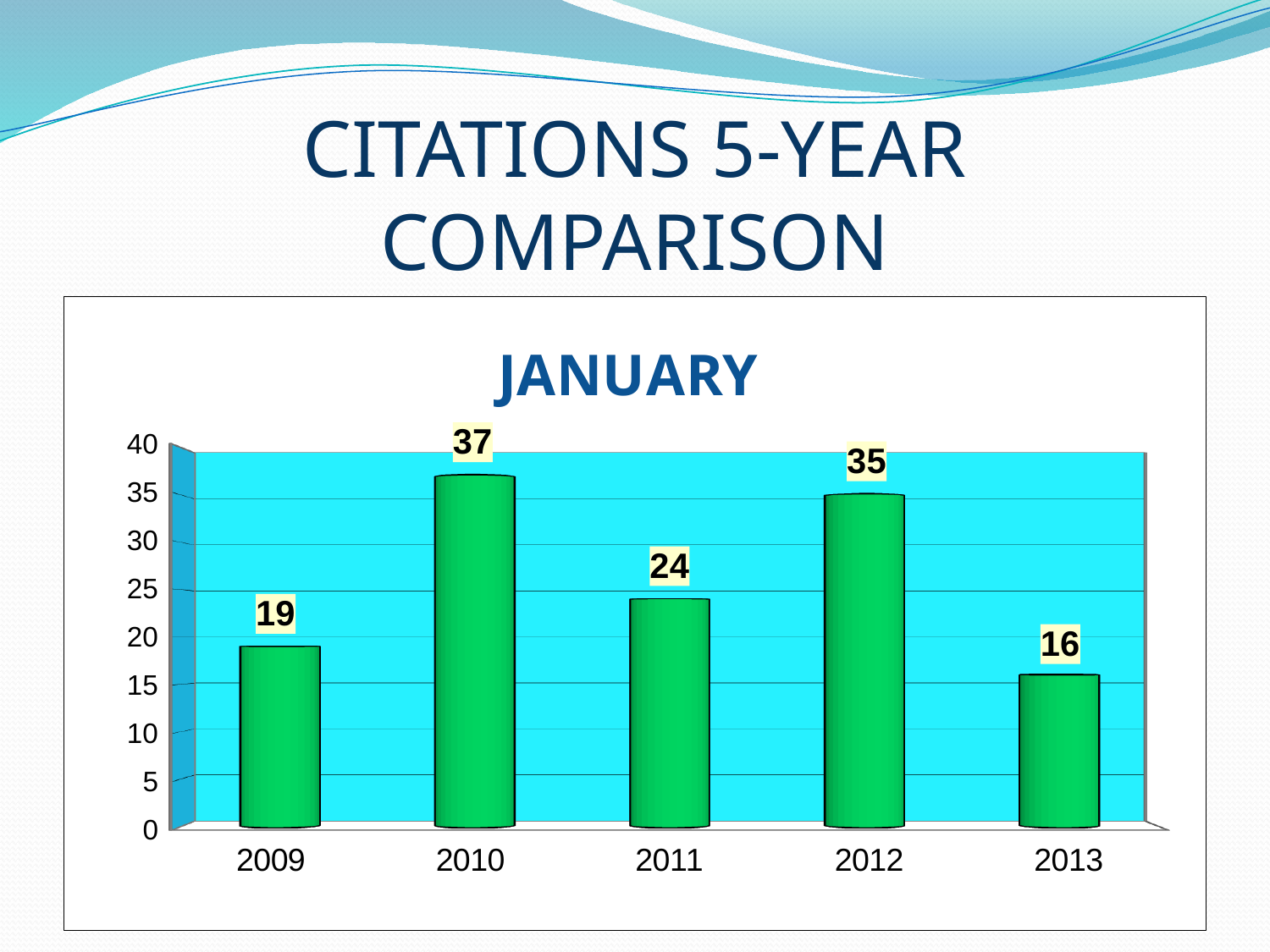
What is the value for 2011? 24 What is the value for 2013? 16 What kind of chart is shown? bar chart What is the difference between the values for 2010 and 2012? 2 Which is larger, the value for 2011 or the value for 2012? 2012 What is the difference between the values for 2009 and 2013? 3 What is the title of the chart? JANUARY How many years are shown on the x axis? 5 Is the value for 2009 greater or less than 20? less Which year has the highest value? 2010 What is the value for 2010? 37 Which year has the lowest value? 2013